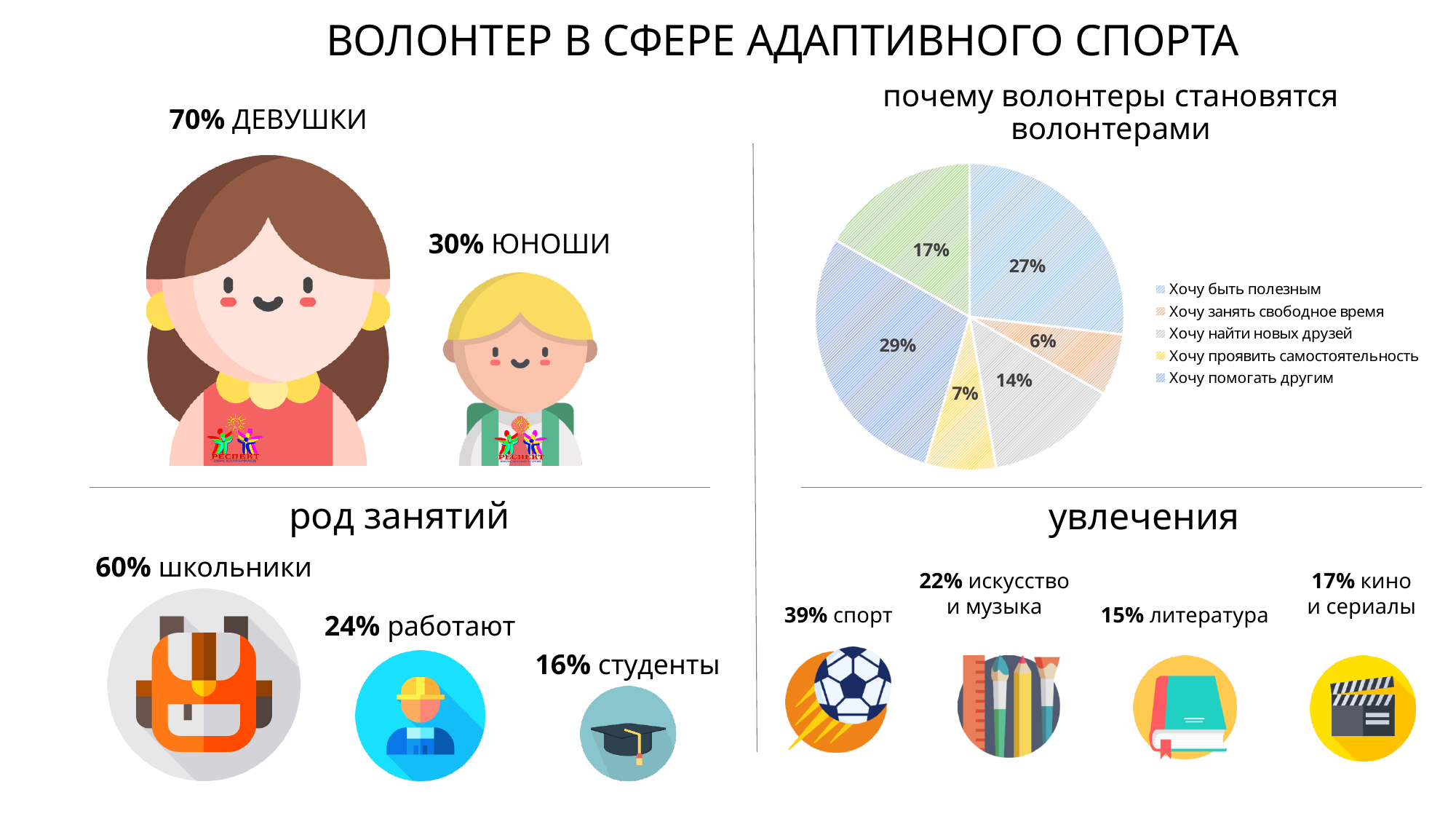
In the pie chart, what percentage is shown for "Хочу найти новых друзей"? 14% In the pie chart, what percentage is shown for "Хочу проявить самостоятельность"? 7% In the pie chart, what is the difference in percentage points between "Хочу помогать другим" and "Хочу быть полезным"? 2 How many slices does the pie chart have? 6 In the pie chart, what percentage is shown for "Хочу быть полезным"? 27% In the pie chart, what percentage is shown for "Хочу помогать другим"? 29% Which legend category has the smallest slice in the pie chart? Хочу занять свободное время Which legend category has the largest slice in the pie chart? Хочу помогать другим In the pie chart, what percentage is shown for "Хочу занять свободное время"? 6% How many entries does the legend of the pie chart list? 5 In the pie chart, which is larger: "Хочу найти новых друзей" or "Хочу проявить самостоятельность"? Хочу найти новых друзей What kind of chart is shown under the heading "почему волонтеры становятся волонтерами"? pie chart